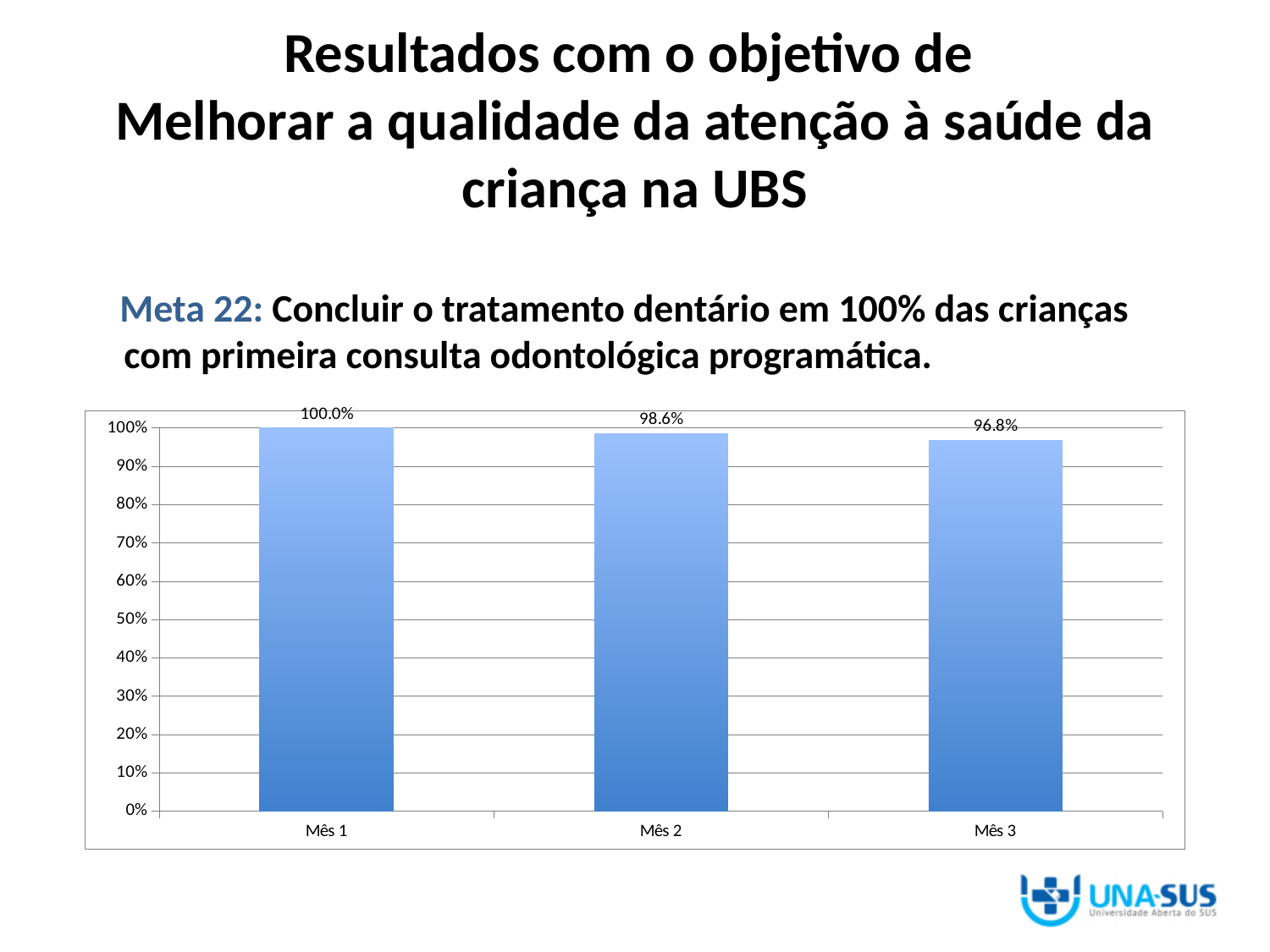
What is the value for Mês 2? 98.6% Which month has the highest value? Mês 1 How many months are shown on the x axis? 3 What is the value for Mês 1? 100.0% Which month has the lowest value? Mês 3 What is the difference between the values for Mês 2 and Mês 3? 1.8% Do the values rise or fall from Mês 1 to Mês 3? fall Which is larger, the value for Mês 1 or the value for Mês 2? Mês 1 What is the difference between the values for Mês 1 and Mês 3? 3.2% Is the value for Mês 3 greater or less than 90%? greater What kind of chart is shown on the slide? bar chart What is the value for Mês 3? 96.8%